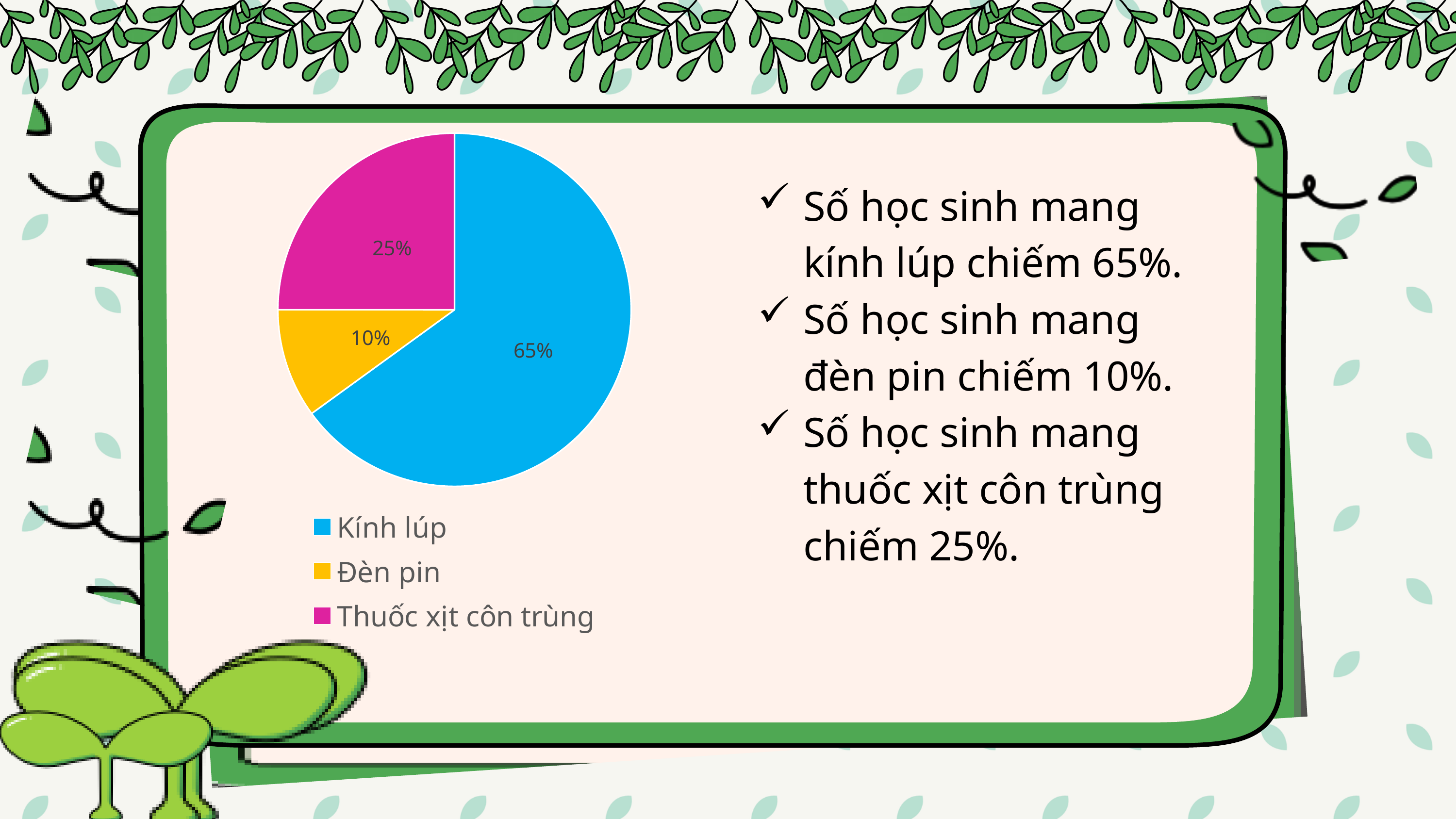
What colour is the Đèn pin slice in the pie chart? yellow What is the difference in percentage points between Kính lúp and Thuốc xịt côn trùng? 40 Which category has the smallest slice of the pie chart? Đèn pin What colour is the Kính lúp slice in the pie chart? blue Which category has the largest slice of the pie chart? Kính lúp What is the difference in percentage points between Thuốc xịt côn trùng and Đèn pin? 15 What percentage of the pie chart is Đèn pin? 10% Which is larger in the pie chart, Đèn pin or Thuốc xịt côn trùng? Thuốc xịt côn trùng What percentage of the pie chart is Kính lúp? 65% What kind of chart is shown on the slide? pie chart What percentage of the pie chart is Thuốc xịt côn trùng? 25% How many categories does the pie chart have? 3